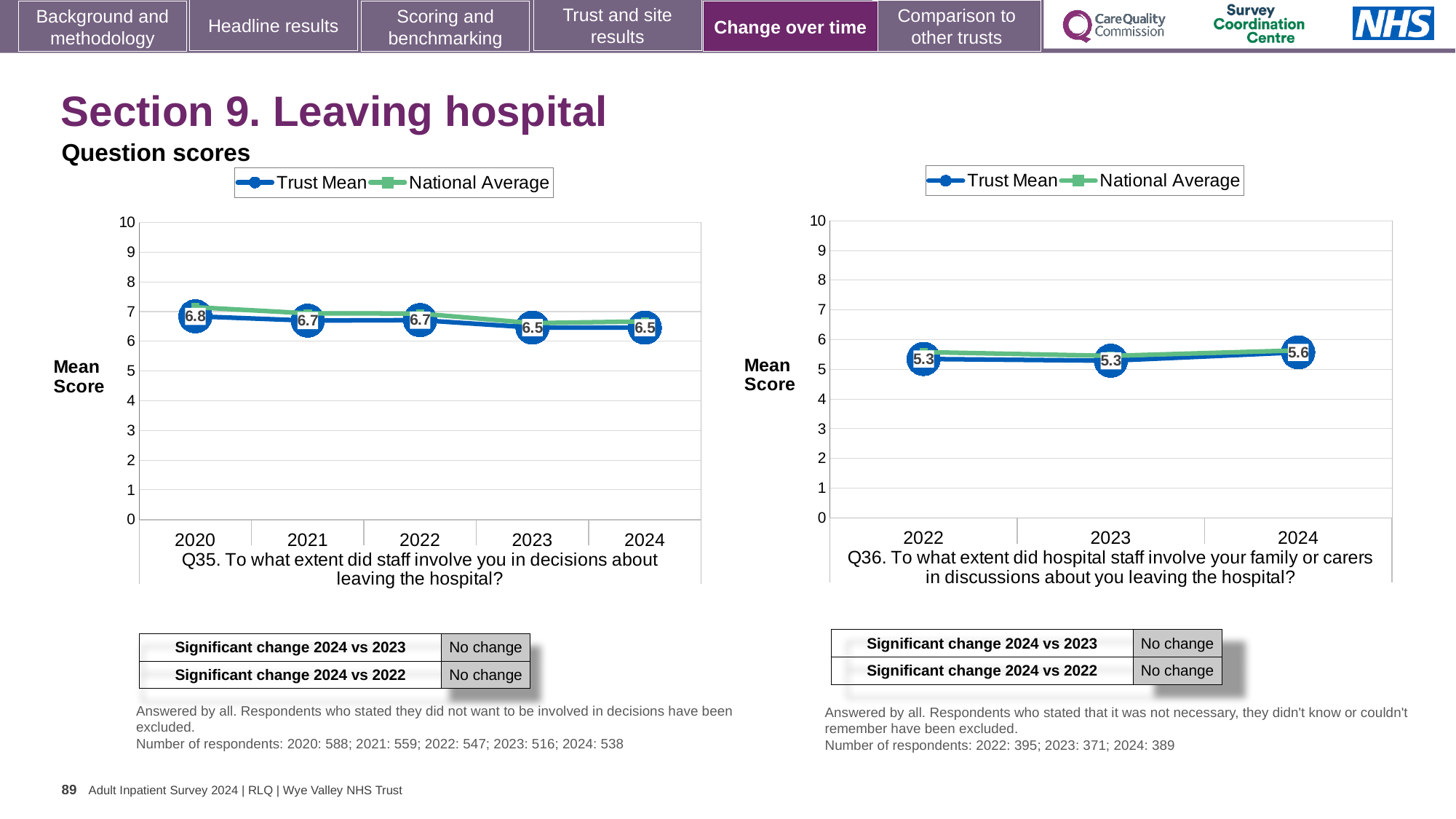
In the Q35 chart (left), which year has the highest Trust Mean? 2020 In the Q36 chart (right), which year has the highest Trust Mean? 2024 How many series does the legend of the Q36 chart (right) list? 2 In the Q35 chart (left), what is the difference between the Trust Mean for 2020 and the Trust Mean for 2024? 0.3 In the Q36 chart (right), what is the Trust Mean for 2024? 5.6 How many years are plotted on the x axis of the Q35 chart (left)? 5 What kind of chart is the Q35 chart (left)? line chart In the Q36 chart (right), what is the Trust Mean for 2022? 5.3 In the Q35 chart (left), what is the Trust Mean for 2020? 6.8 In the Q35 chart (left), what is the Trust Mean for 2024? 6.5 In the Q36 chart (right), what is the difference between the Trust Mean for 2024 and the Trust Mean for 2023? 0.3 In the Q35 chart (left), is the Trust Mean for 2021 larger or smaller than the Trust Mean for 2023? larger